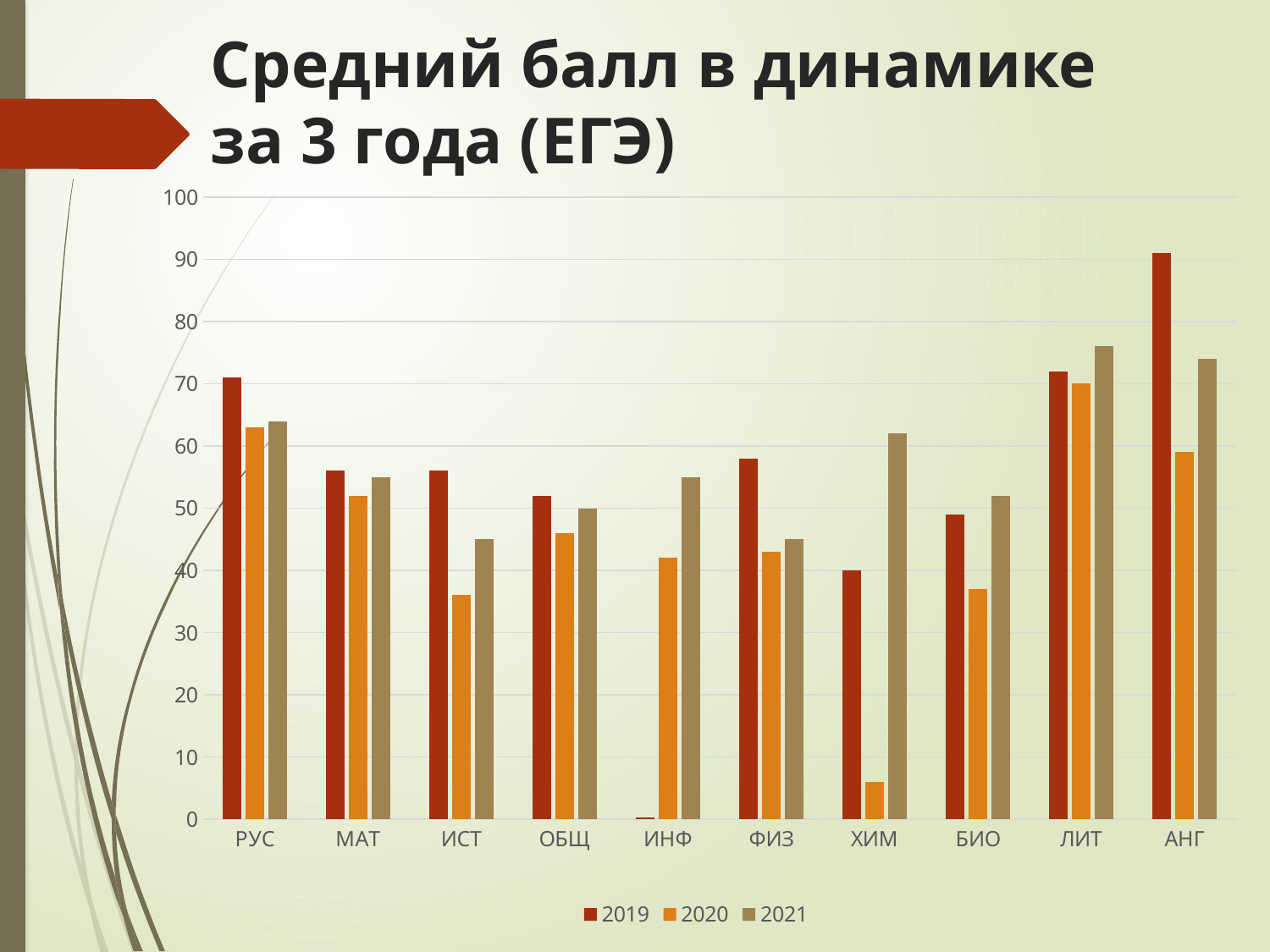
How many subjects (categories) are shown on the x axis? 10 For ХИМ, which year has the larger value, 2019 or 2021? 2021 How many series does the legend list? 3 What is the title of the chart on the slide? Средний балл в динамике за 3 года (ЕГЭ) What kind of chart is shown on the slide? bar chart Is the 2019 value for АНГ greater or less than 80? greater For ИСТ, which year has the larger value, 2019 or 2020? 2019 Is the 2021 value for ИНФ greater or less than 50? greater Which subject has the lowest value for 2020? ИНФ Is the 2020 value for ХИМ greater or less than 10? less Which subject has the highest value for 2019? АНГ